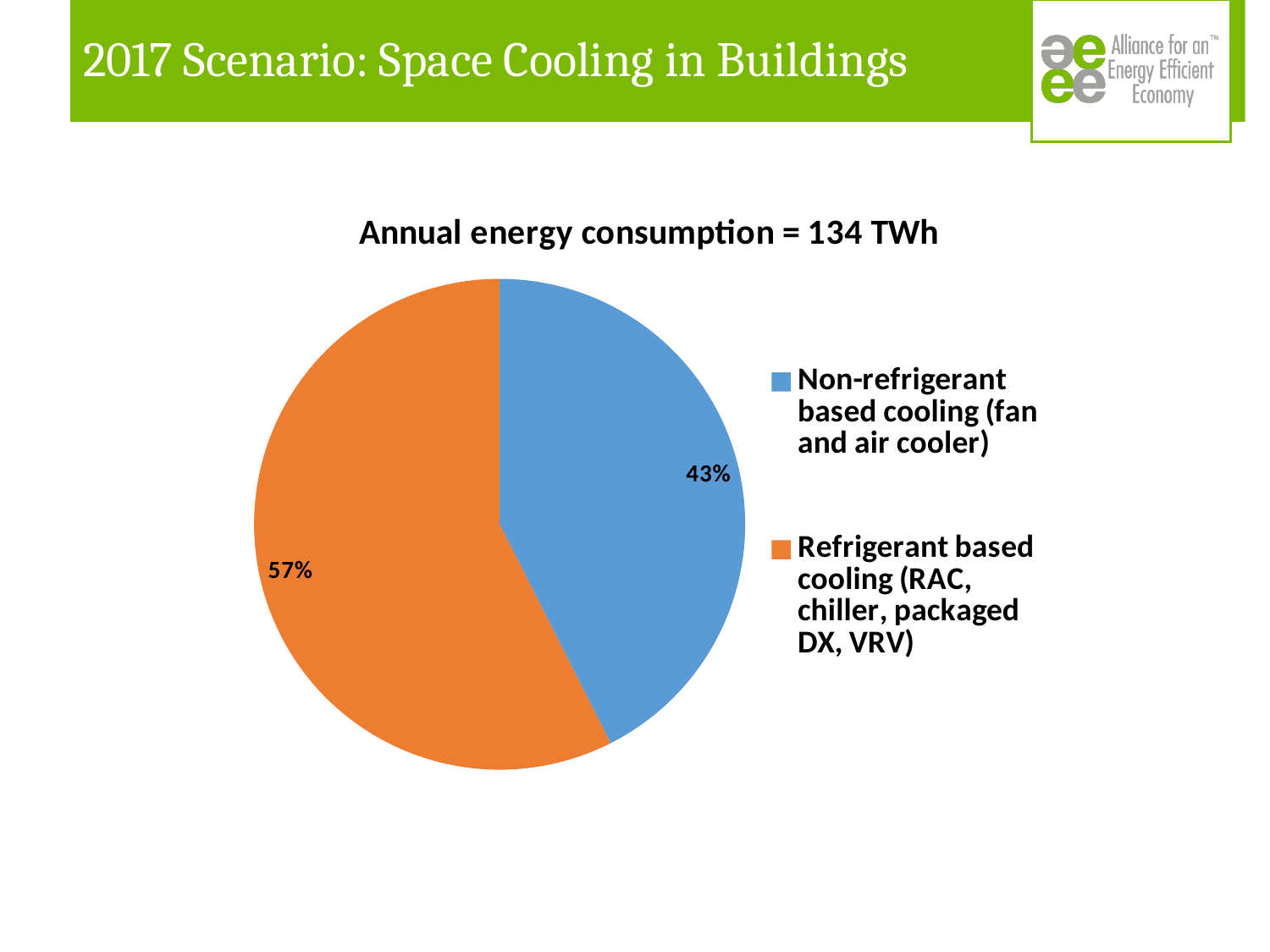
What type of chart is shown on the slide? Pie chart Which category has the largest share of the pie? Refrigerant based cooling (RAC, chiller, packaged DX, VRV) How many entries does the legend list? 2 How many categories does the pie chart show? 2 What is the difference in percentage points between the refrigerant based cooling share and the non-refrigerant based cooling share? 14 percentage points Which category has the smallest share of the pie? Non-refrigerant based cooling (fan and air cooler) What share of annual energy consumption is from refrigerant based cooling (RAC, chiller, packaged DX, VRV)? 57% Which is larger: the share for refrigerant based cooling or the share for non-refrigerant based cooling? Refrigerant based cooling What is the title of the chart? Annual energy consumption = 134 TWh What share of annual energy consumption is from non-refrigerant based cooling (fan and air cooler)? 43% What colour represents non-refrigerant based cooling (fan and air cooler) in the pie chart? Blue Is the share for refrigerant based cooling greater or less than 50%? greater